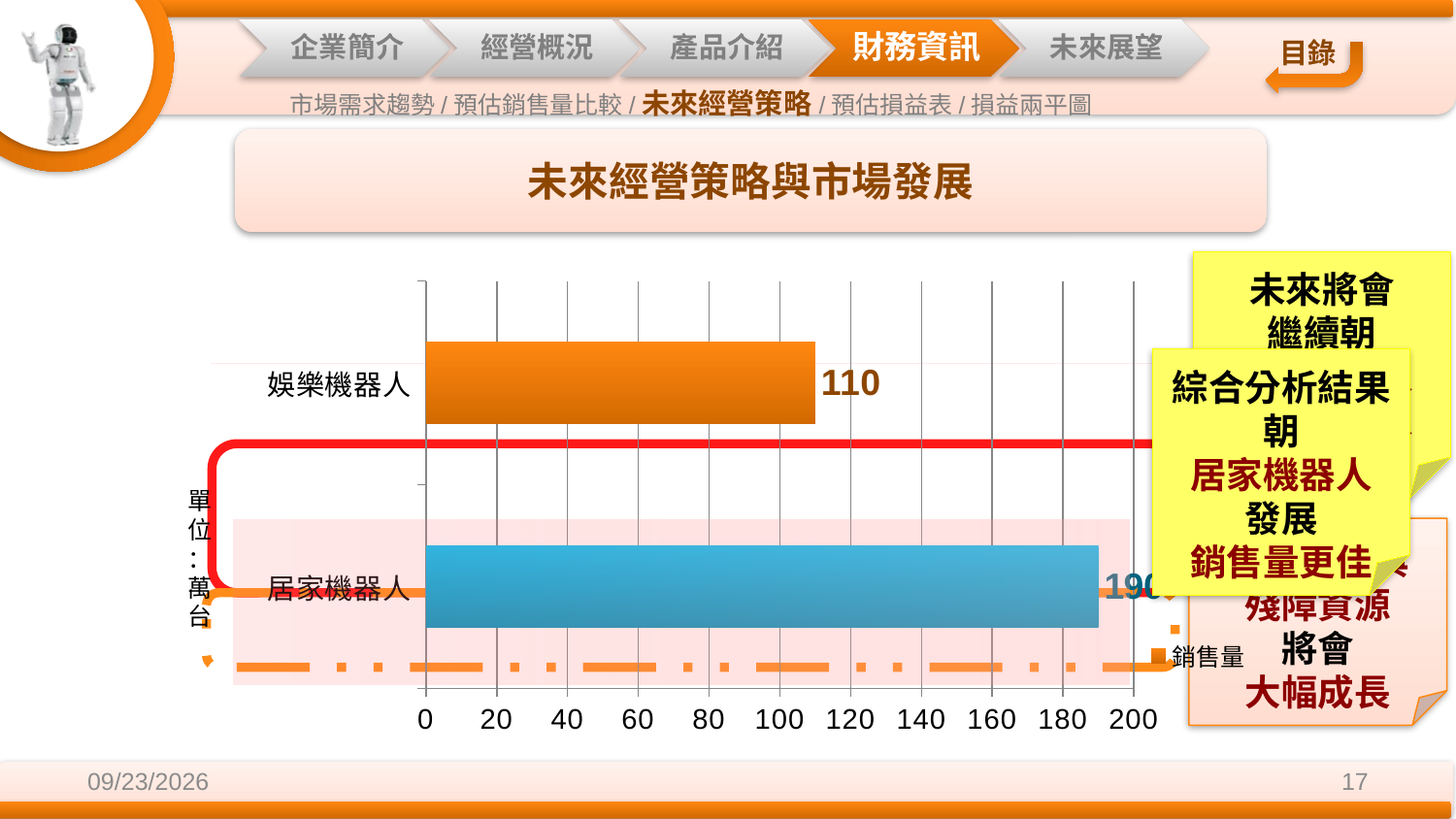
What is the difference between the values for 居家機器人 and 娛樂機器人? 80 What is the value for 居家機器人? 190 What kind of chart is shown on the slide? bar chart How many categories are shown in the chart? 2 Is the value for 居家機器人 greater or less than 180? greater What is the value for 娛樂機器人? 110 Which is larger, the value for 娛樂機器人 or the value for 居家機器人? 居家機器人 Which category has the highest value? 居家機器人 What unit is indicated for the chart's values? 萬台 Which category has the lowest value? 娛樂機器人 Is the value for 娛樂機器人 greater or less than 120? less What is the maximum value shown on the chart's value axis? 200